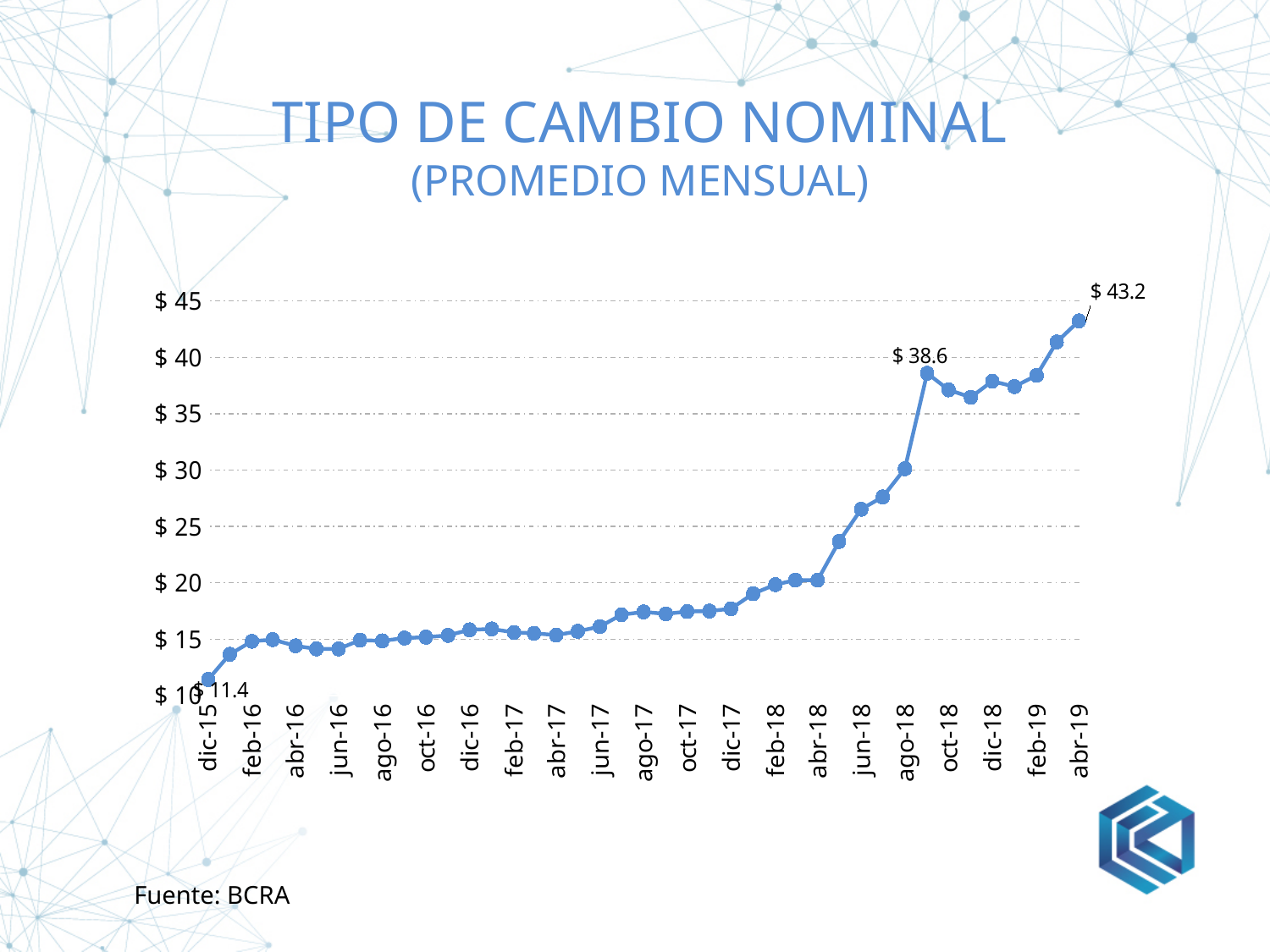
What kind of chart is shown on the slide? line chart What is the value labelled at the peak reached in late 2018, just after ago-18? $ 38.6 What is the value labelled at dic-15, the first point of the series? $ 11.4 Is the value for oct-18 greater or less than 35? greater Does the exchange rate generally rise or fall from dic-15 to abr-19? rise Which labelled point has the highest value: dic-15, the late-2018 peak, or abr-19? abr-19 What is the difference between the labelled value at abr-19 and the labelled late-2018 peak? $ 4.6 What is the value labelled at abr-19, the last point of the series? $ 43.2 What source is cited for the chart data? BCRA Is the value for jun-18 greater or less than 25? greater Is the value for dic-17 greater or less than 20? less What is the difference between the labelled values at abr-19 and dic-15? $ 31.8